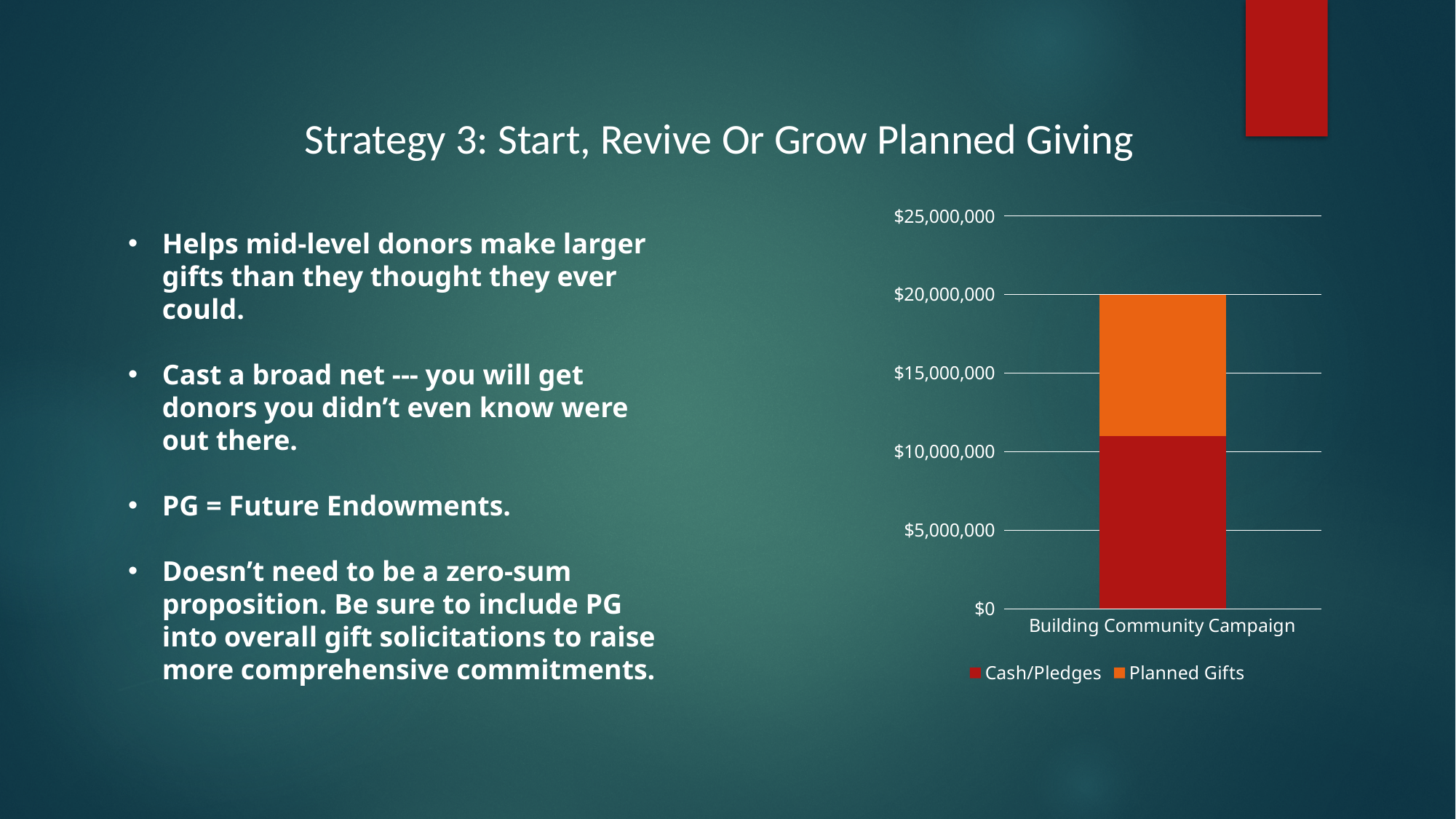
What kind of chart is shown on the slide? bar chart Is the total height of the Building Community Campaign stacked bar greater or less than $15,000,000? greater What is the name of the category shown on the x axis of the chart? Building Community Campaign Is the value for Cash/Pledges in the Building Community Campaign bar greater or less than $10,000,000? greater Is the value for Planned Gifts in the Building Community Campaign bar greater or less than $10,000,000? less How many series does the chart legend list? 2 What is the highest value labelled on the y axis of the chart? $25,000,000 Which series is shown in orange in the chart? Planned Gifts Which series contributes more to the Building Community Campaign bar, Cash/Pledges or Planned Gifts? Cash/Pledges Which series is the smaller segment of the Building Community Campaign bar? Planned Gifts How many categories are plotted on the x axis of the chart? 1